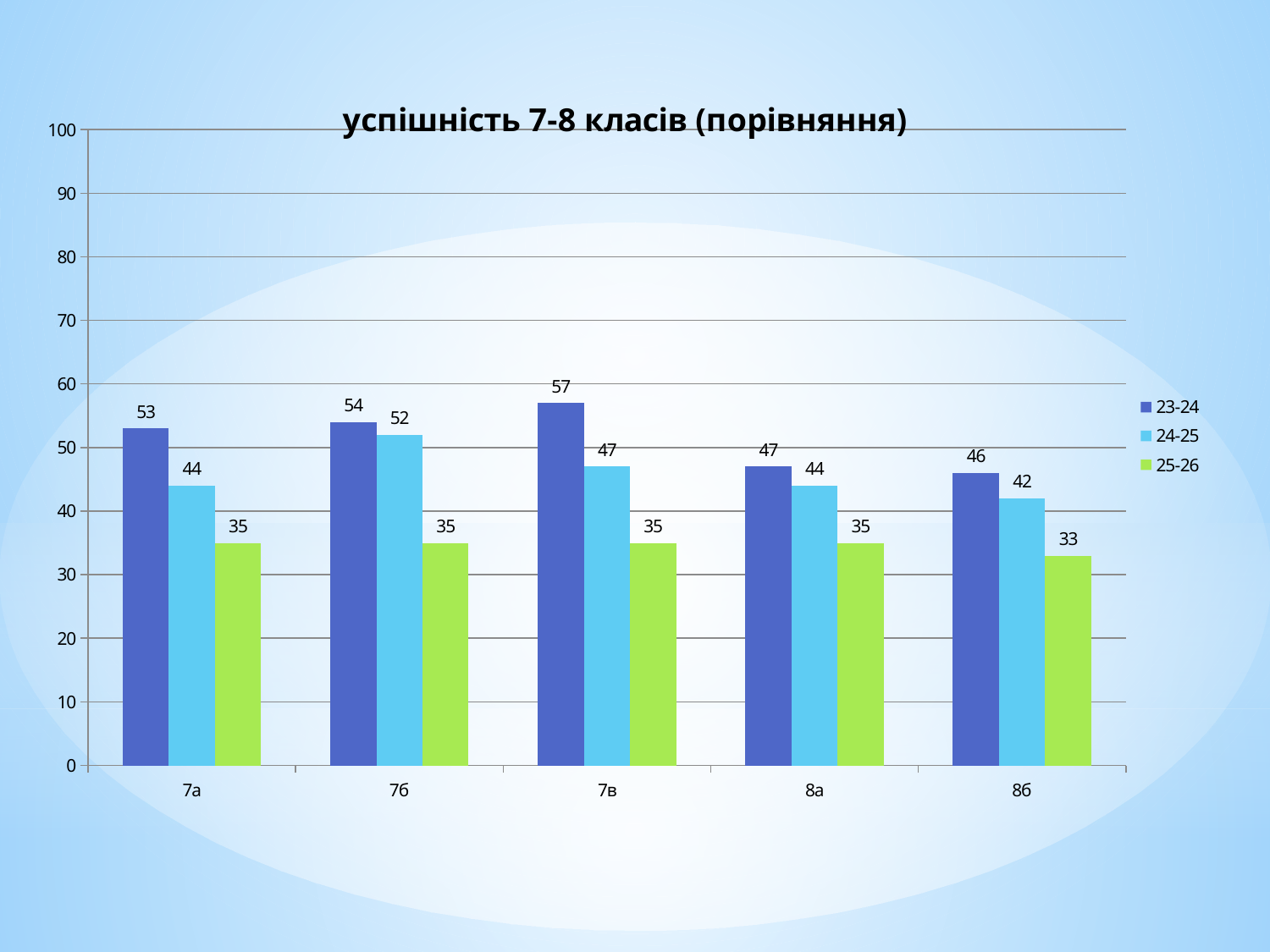
Which category has the lowest value in the 25-26 series? 8б What is the value for 7в in the 23-24 series? 57 What is the value for 7б in the 25-26 series? 35 How many categories are shown on the x axis? 5 How many series does the legend list? 3 What is the title of the chart? успішність 7-8 класів (порівняння) What kind of chart is shown on the slide? bar chart Which is larger: the 24-25 value for 7б or the 24-25 value for 7в? 7б What is the difference between the 23-24 and 24-25 values for 7а? 9 What is the value for 8б in the 24-25 series? 42 Which category has the highest value in the 23-24 series? 7в Is the 23-24 value for 8а greater or less than 40? greater